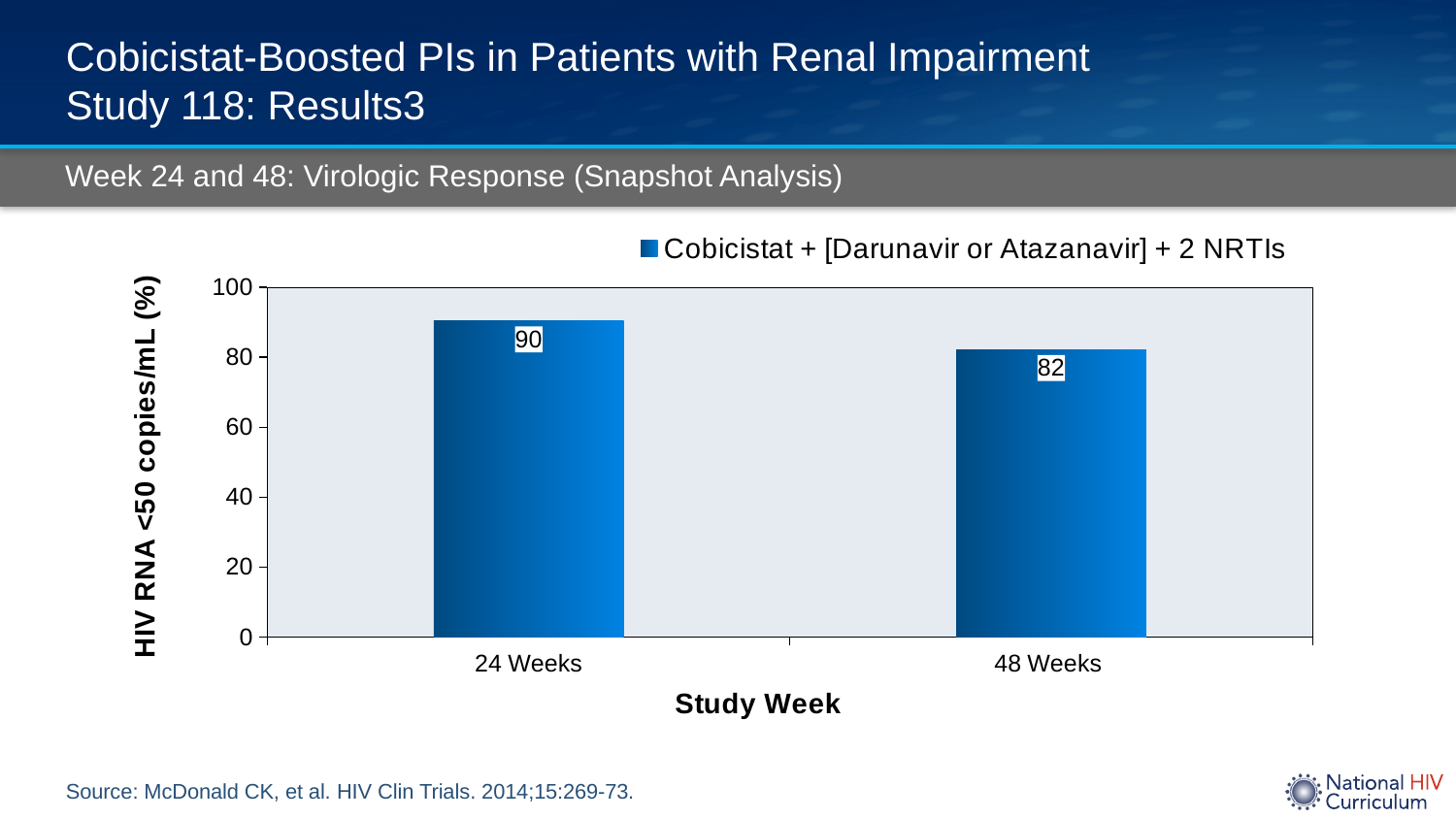
What is the label of the y axis? HIV RNA <50 copies/mL (%) How many study week categories are shown on the x axis? 2 Which study week has the lowest value? 48 Weeks What kind of chart is shown on the slide? bar chart Which study week has the highest value? 24 Weeks What is the value for 48 Weeks? 82 Which is larger, the value for 24 Weeks or the value for 48 Weeks? 24 Weeks Do the values rise or fall from 24 Weeks to 48 Weeks? fall How many series does the legend list? 1 What is the difference between the values for 24 Weeks and 48 Weeks? 8 What is the value for 24 Weeks? 90 Is the value for 48 Weeks greater or less than 60? greater